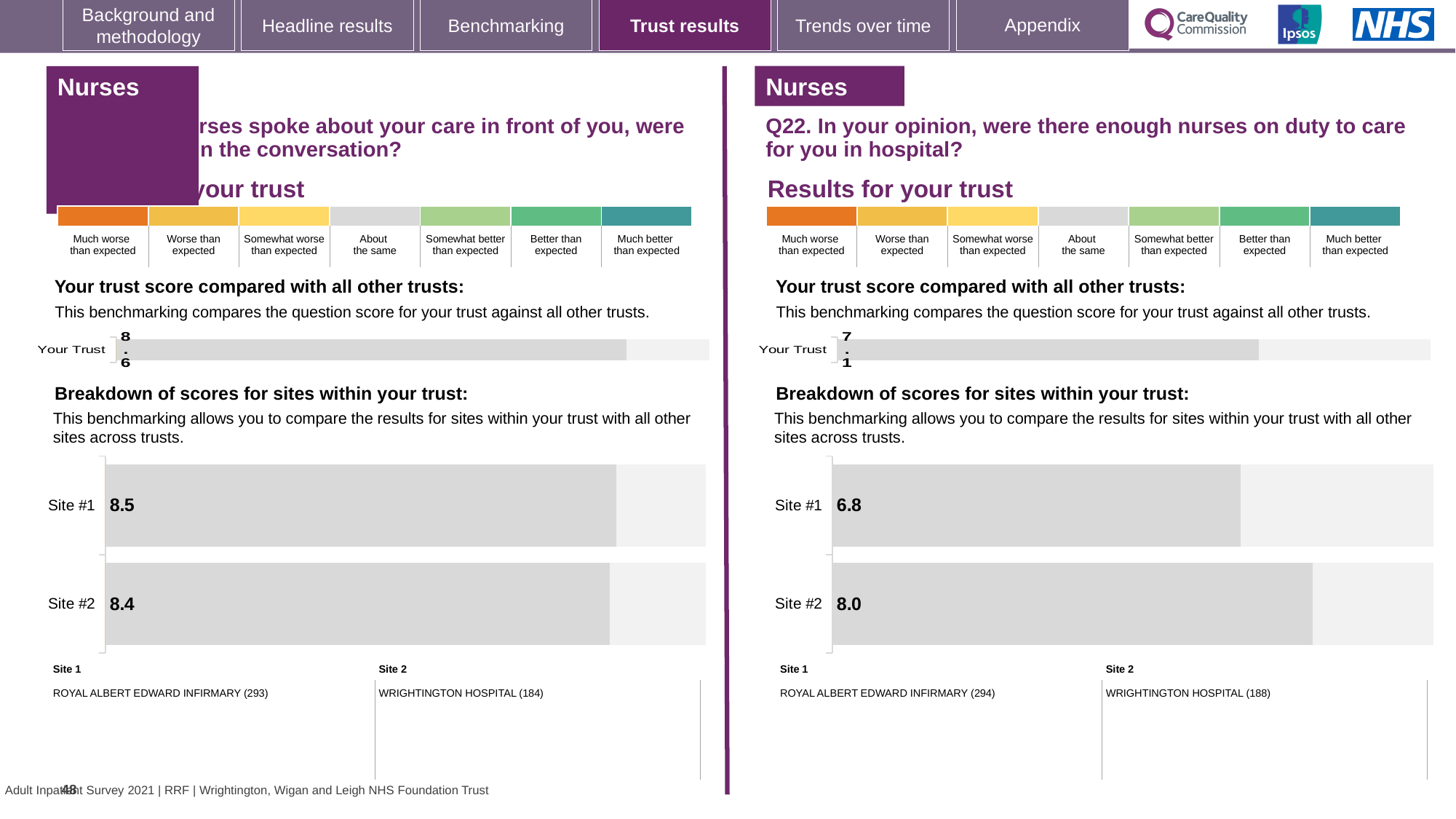
On the left-hand slide section, is the Site #1 score larger or smaller than the Site #2 score in the site breakdown chart? larger On the left-hand slide section, what is the difference between the Site #1 and Site #2 scores in the site breakdown chart? 0.1 How many sites are shown in the breakdown of scores chart on the right-hand slide section (Q22)? 2 What type of chart is used for the breakdown of scores for sites within your trust on the right-hand slide section (Q22)? bar chart On the left-hand slide section, what is the score for Site #2 in the breakdown of scores for sites within your trust? 8.4 On the right-hand slide section (Q22), what is the difference between the Site #2 and Site #1 scores in the site breakdown chart? 1.2 On the right-hand slide section (Q22), what is the 'Your Trust' score in the chart comparing your trust with all other trusts? 7.1 On the left-hand slide section, what is the score for Site #1 in the breakdown of scores for sites within your trust? 8.5 On the right-hand slide section (Q22), what is the score for Site #2 in the breakdown of scores for sites within your trust? 8.0 On the right-hand slide section (Q22), what is the score for Site #1 in the breakdown of scores for sites within your trust? 6.8 On the right-hand slide section (Q22), which site has the higher score in the breakdown of scores for sites within your trust? Site #2 On the left-hand slide section, what is the 'Your Trust' score in the chart comparing your trust with all other trusts? 8.6